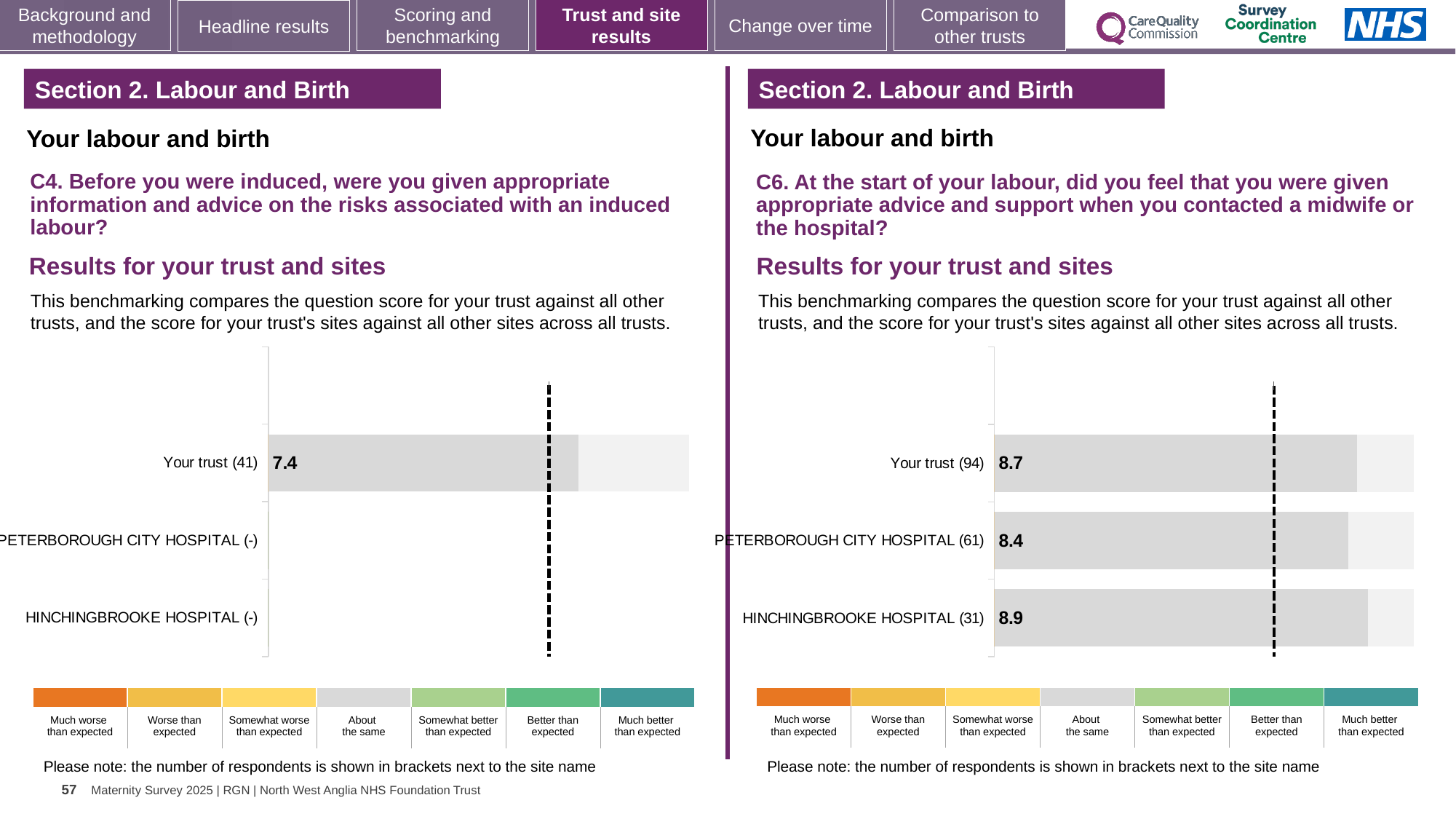
What kind of chart is used in the C4 chart on the left? Bar chart In the C6 chart on the right, what is the difference between the scores for HINCHINGBROOKE HOSPITAL and PETERBOROUGH CITY HOSPITAL? 0.5 In the C6 chart on the right, what is the score for Your trust? 8.7 In the C6 chart on the right, what is the score for PETERBOROUGH CITY HOSPITAL? 8.4 In the C6 chart on the right, which site or trust has the highest score? HINCHINGBROOKE HOSPITAL In the C6 chart on the right, which has the larger score, Your trust or PETERBOROUGH CITY HOSPITAL? Your trust In the C4 chart on the left, what is the score for Your trust? 7.4 In the C4 chart on the left, how many respondents are shown in brackets for Your trust? 41 In the C6 chart on the right, which site or trust has the lowest score? PETERBOROUGH CITY HOSPITAL How many categories (trust and sites) are listed in the C6 chart on the right? 3 In the C6 chart on the right, what is the score for HINCHINGBROOKE HOSPITAL? 8.9 In the C6 chart on the right, how many respondents are shown in brackets for Your trust? 94